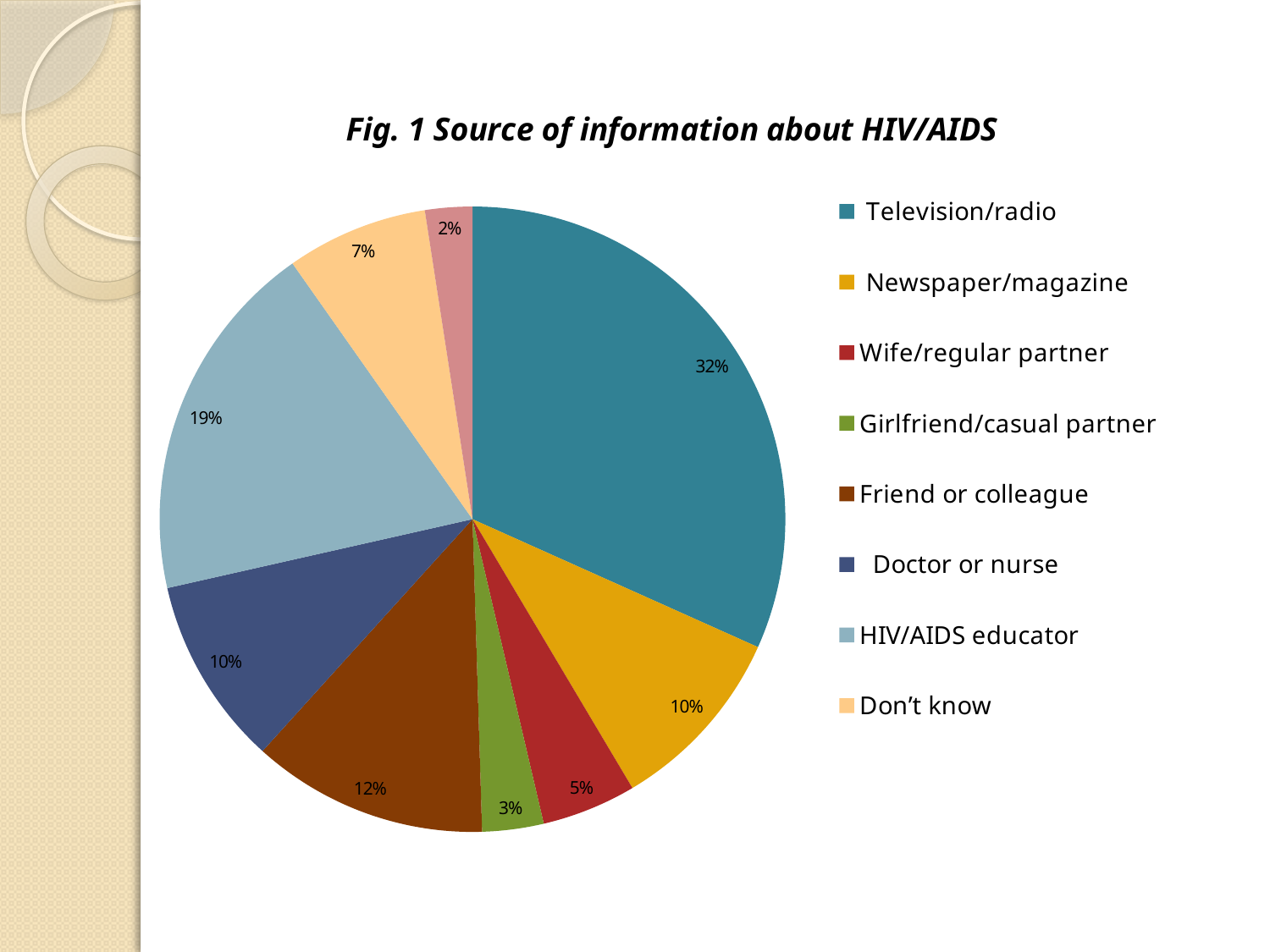
What percentage of the pie is HIV/AIDS educator? 19% How many entries does the legend list? 8 What type of chart is shown on the slide? pie chart Which has a larger share, Wife/regular partner or Friend or colleague? Friend or colleague What is the title of the chart? Fig. 1 Source of information about HIV/AIDS What percentage of the pie is Friend or colleague? 12% What percentage of the pie is Girlfriend/casual partner? 3% What colour is the Doctor or nurse slice? dark blue Which source of information has the largest share of the pie? Television/radio What is the difference in percentage points between Television/radio and HIV/AIDS educator? 13 What percentage of the pie is Television/radio? 32% What percentage of the pie is Don't know? 7%